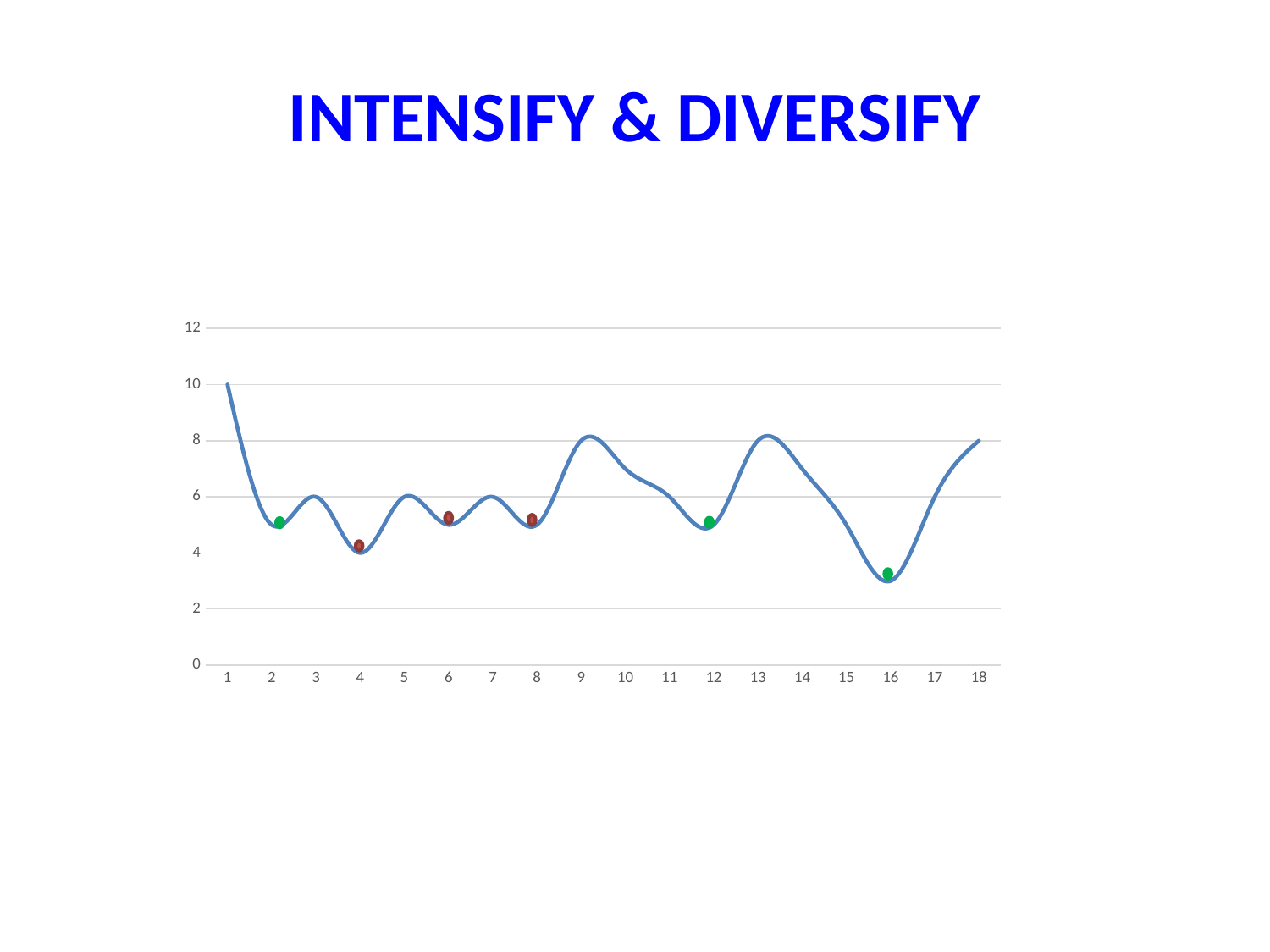
At which x value does the line reach its highest point? 1 What is the title of the slide above the chart? INTENSIFY & DIVERSIFY Is the value of the line at x = 4 greater or less than 6? less What is the value of the line at x = 18? 8 How many points are labelled along the x axis of the chart? 18 Is the value of the line at x = 9 greater or less than 6? greater What kind of chart is shown on the slide? line chart What is the value of the line at x = 1? 10 Is the value of the line at x = 16 greater or less than 4? less At which x value does the line reach its lowest point? 16 Which is larger, the value of the line at x = 1 or at x = 16? x = 1 Does the line rise or fall between x = 1 and x = 2? fall